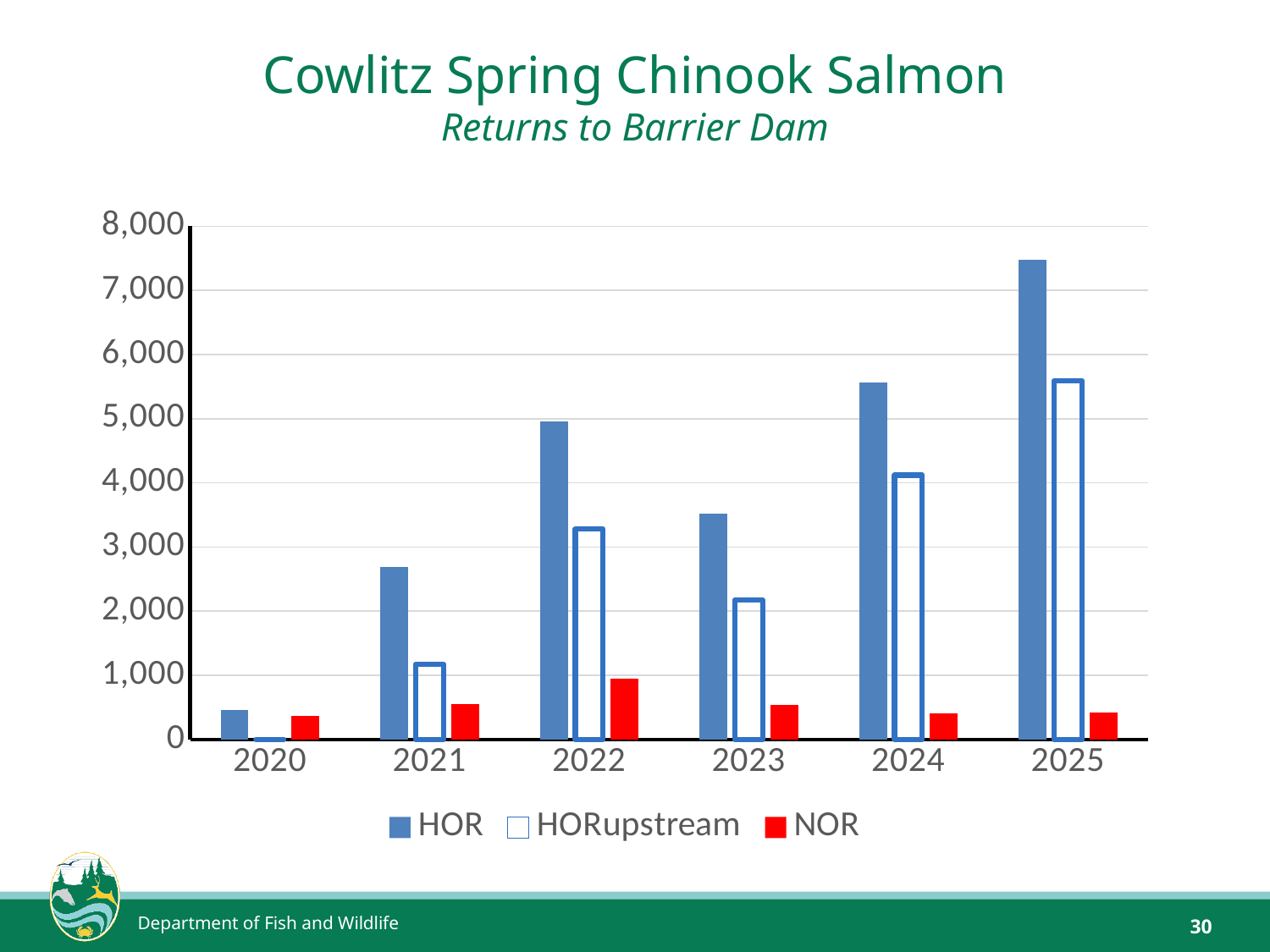
Is the HOR value for 2025 greater or less than 7,000? greater Which year has the highest HORupstream value? 2025 How many series does the legend list? 3 Which year has the lowest HOR value? 2020 How many years are shown on the x axis? 6 What are the three series named in the legend? HOR, HORupstream, NOR Which is larger, the HOR value for 2023 or the HOR value for 2024? 2024 Is the HORupstream value for 2021 greater or less than 2,000? less What kind of chart is shown on the slide? Bar chart Which year has the highest HOR value? 2025 Which year has the highest NOR value? 2022 Is the HOR value for 2022 greater or less than 4,000? greater